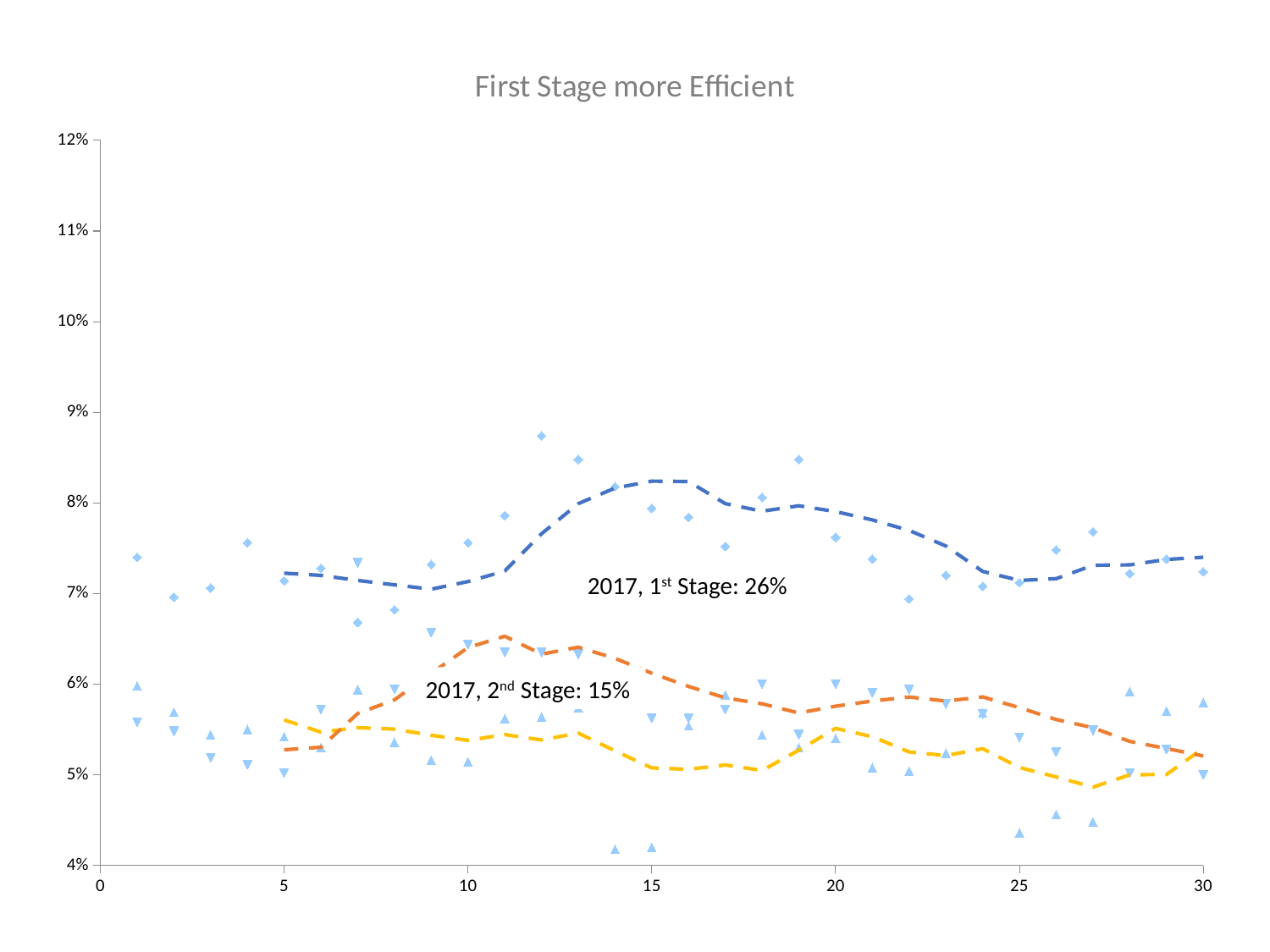
Is the value of the lowest triangle-marker point at x = 14 greater or less than 5%? less Is the value of the diamond-marker point at x = 12 greater or less than 8%? greater Is the value of the diamond-marker point at x = 22 greater or less than 7%? less Which is larger: the diamond-marker value at x = 12 or the diamond-marker value at x = 1? x = 12 What percentage is given in the annotation for the 2017 1st Stage? 26% What is the title of the chart? First Stage more Efficient Does the blue dashed trend line rise or fall between x = 5 and x = 15? rise At which x value does the diamond-marker series reach its highest point? 12 Does the yellow dashed trend line rise or fall between x = 5 and x = 15? fall What kind of chart is shown on the slide? scatter chart